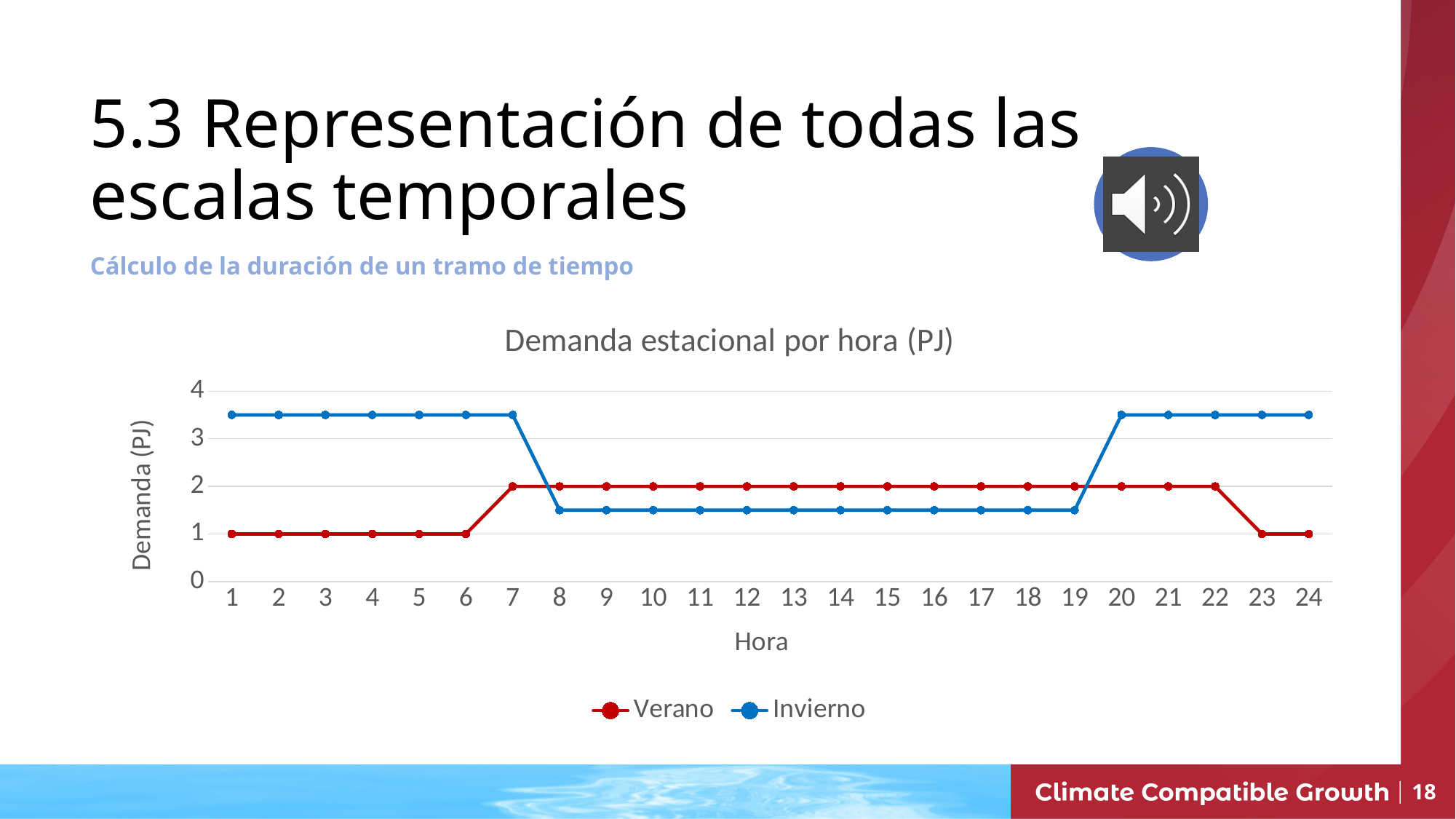
What kind of chart is shown on the slide? line chart What is the Verano demand at hour 24? 1 How many hours are plotted along the x axis? 24 What is the Verano demand at hour 3? 1 At hour 4, which series has the higher demand, Verano or Invierno? Invierno Is the Invierno demand at hour 10 greater or less than 2? less Is the Invierno demand at hour 2 greater or less than 3? greater How many series does the legend list? 2 What is the difference between the Verano demand at hour 7 and at hour 6? 1 At hour 15, which series has the higher demand, Verano or Invierno? Verano What is the title of the chart? Demanda estacional por hora (PJ) What is the Verano demand at hour 12? 2